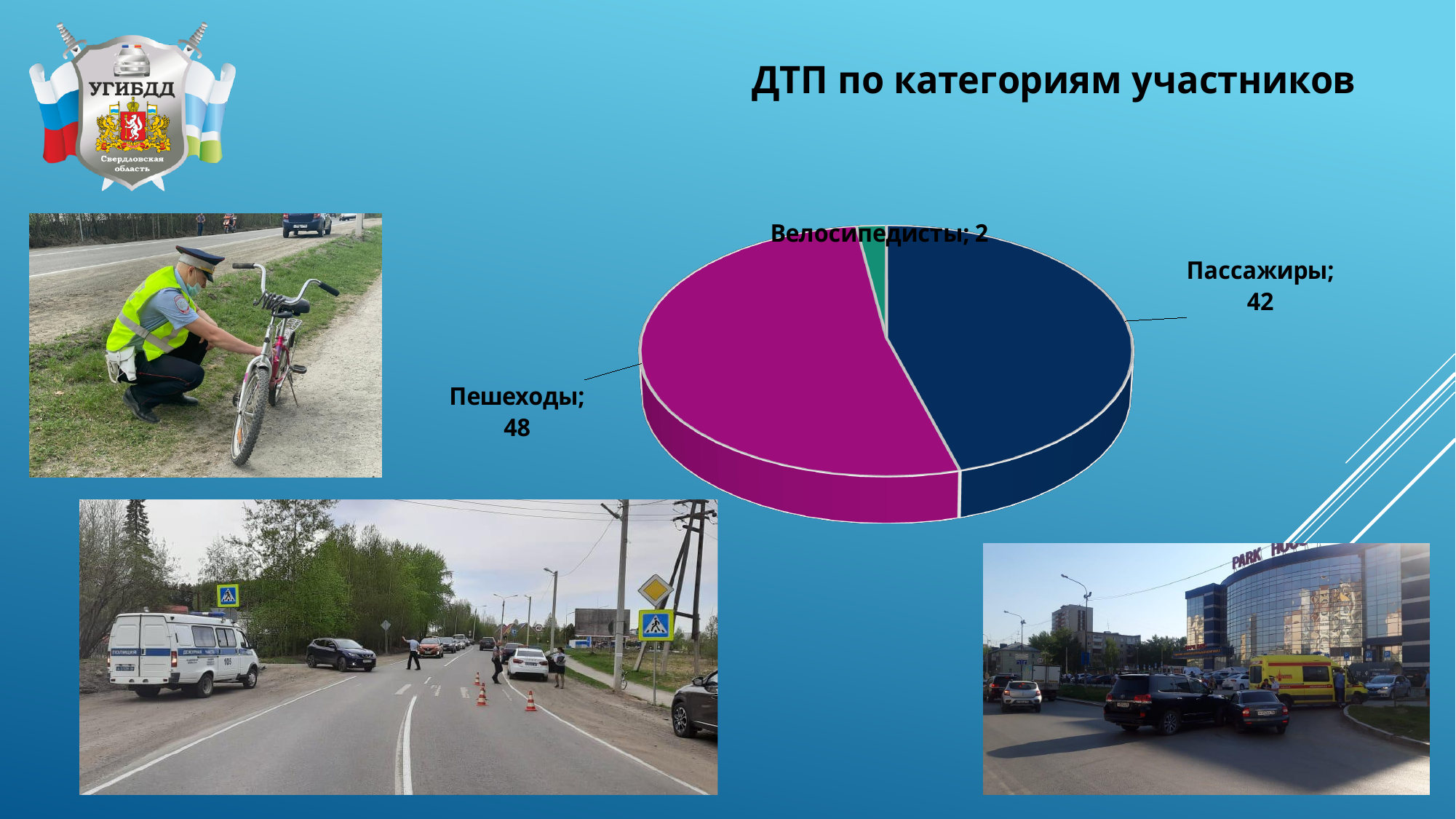
What colour is the Пешеходы slice? Magenta (purple-pink) Which is larger, the value for Пассажиры or the value for Велосипедисты? Пассажиры What is the value for Велосипедисты? 2 What is the difference between the values for Пешеходы and Пассажиры? 6 What is the value for Пассажиры? 42 What is the value for Пешеходы? 48 How many categories does the pie chart show? 3 What type of chart is shown on the slide? Pie chart What is the title of the chart? ДТП по категориям участников What is the total of all the values in the pie chart? 92 Which category has the smallest value? Велосипедисты Which category has the largest value? Пешеходы